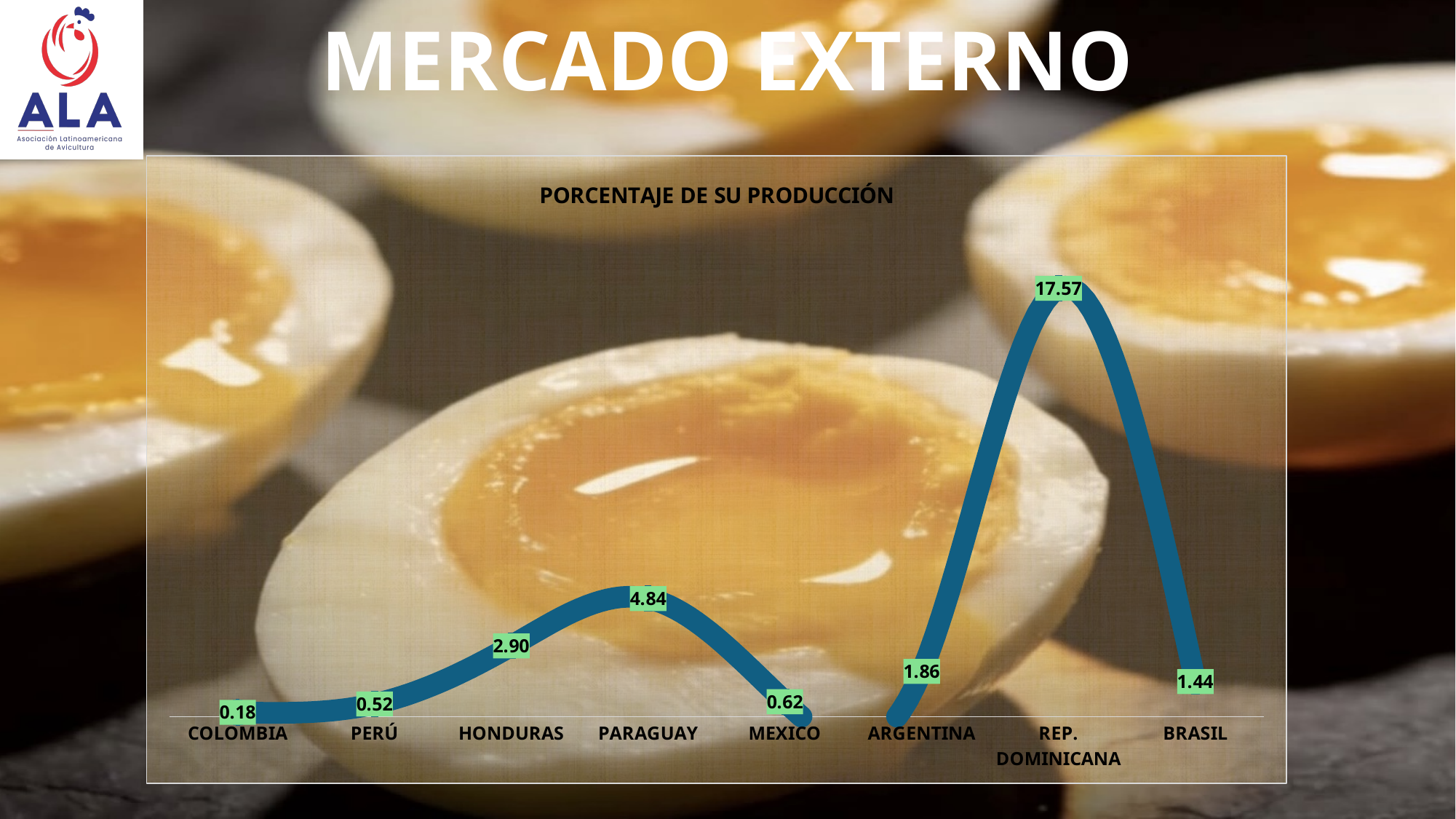
What is the value for Brasil in the chart? 1.44 What kind of chart is shown on the slide? Line chart Which has a larger value, Argentina or Brasil? Argentina Which category has the lowest value in the chart? Colombia What is the difference between the values for Rep. Dominicana and Paraguay? 12.73 What is the title of the chart? PORCENTAJE DE SU PRODUCCIÓN How many categories are plotted in the chart? 8 What is the value for Rep. Dominicana in the chart? 17.57 What is the difference between the values for Honduras and Perú? 2.38 What is the value for Paraguay in the chart? 4.84 What is the value for Colombia in the chart? 0.18 Which category has the highest value in the chart? Rep. Dominicana